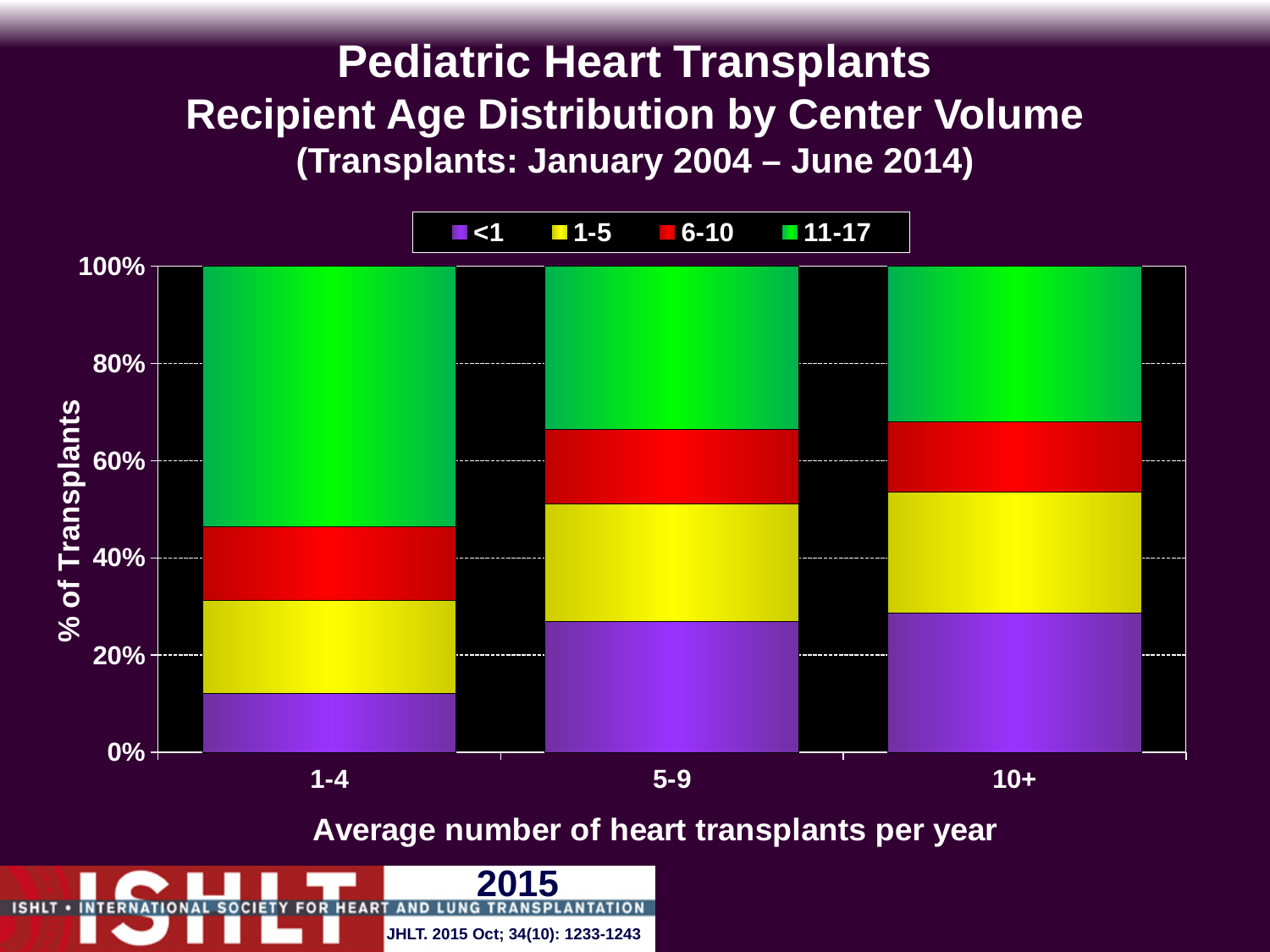
Which center volume category has the largest share of recipients aged 11-17? 1-4 What is the label of the x axis? Average number of heart transplants per year What kind of chart is shown on the slide? Stacked bar chart Is the share of recipients aged 11-17 at centers with 1-4 transplants per year greater or less than 40%? greater How many series does the legend list? 4 Does the share of recipients aged <1 rise or fall as center volume increases from 1-4 to 10+? rise Is the share of recipients aged <1 at centers with 5-9 transplants per year greater or less than 20%? greater Is the share of recipients aged <1 at centers with 1-4 transplants per year greater or less than 20%? less Is the share of recipients aged 11-17 larger at centers with 1-4 or 10+ transplants per year? 1-4 Which center volume category has the smallest share of recipients aged <1? 1-4 How many center volume categories are shown on the x axis? 3 Which colour represents the 6-10 age group in the legend? Red